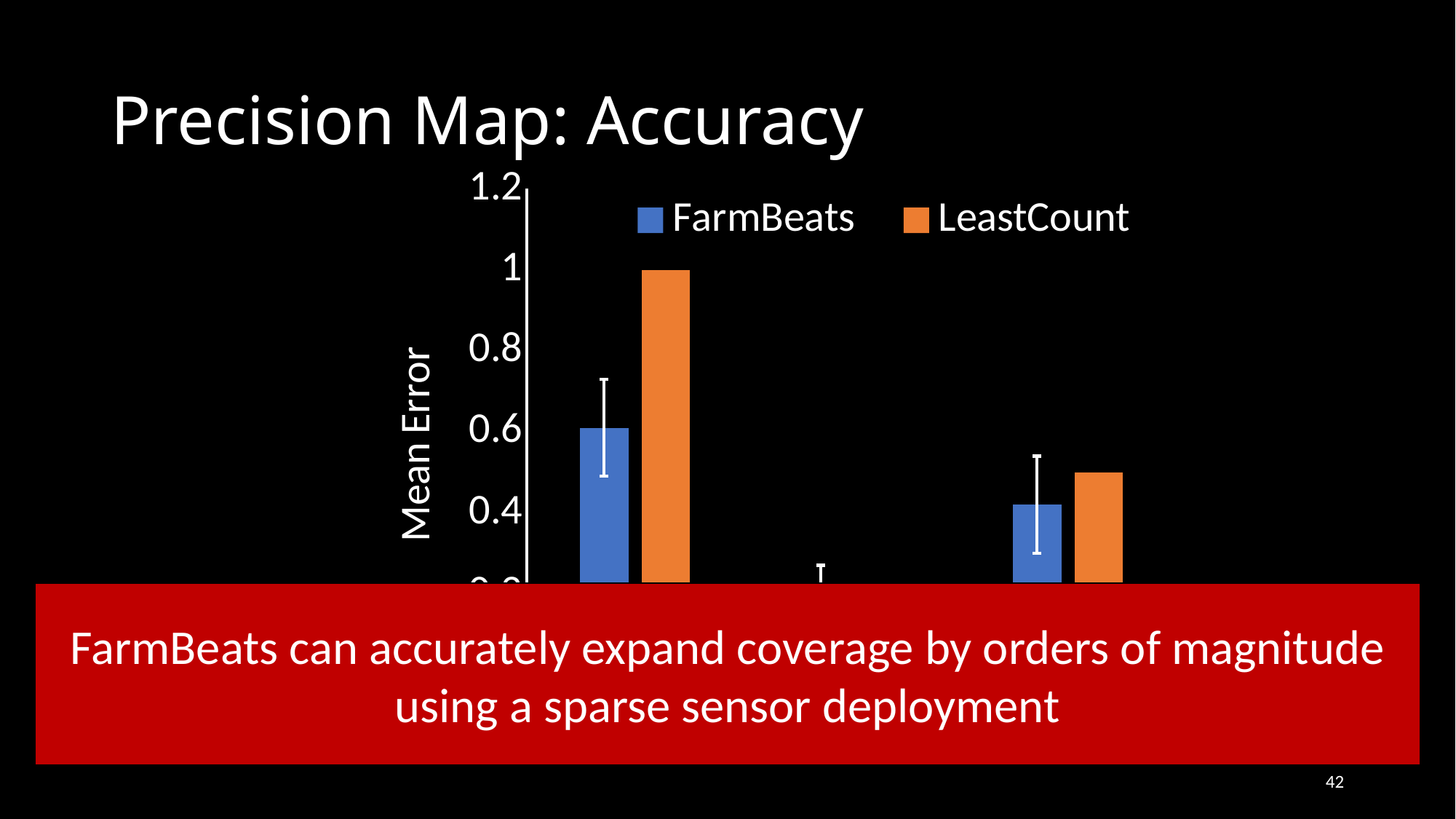
Which bar on the chart has the highest Mean Error? LeastCount in the leftmost group What are the two series named in the chart legend? FarmBeats and LeastCount How many series does the chart legend list? 2 Is the Mean Error of the LeastCount bar in the leftmost group greater or less than 0.8? greater In the leftmost group of bars, which series has the higher Mean Error, FarmBeats or LeastCount? LeastCount In the rightmost group of bars, which series has the higher Mean Error, FarmBeats or LeastCount? LeastCount Is the Mean Error of the FarmBeats bar in the rightmost group greater or less than 0.6? less What type of chart is shown on the slide? bar chart Is the Mean Error of the LeastCount bar in the rightmost group greater or less than 0.6? less What is the Mean Error value of the LeastCount bar in the leftmost group of bars? 1 What is the title of the chart's vertical axis? Mean Error